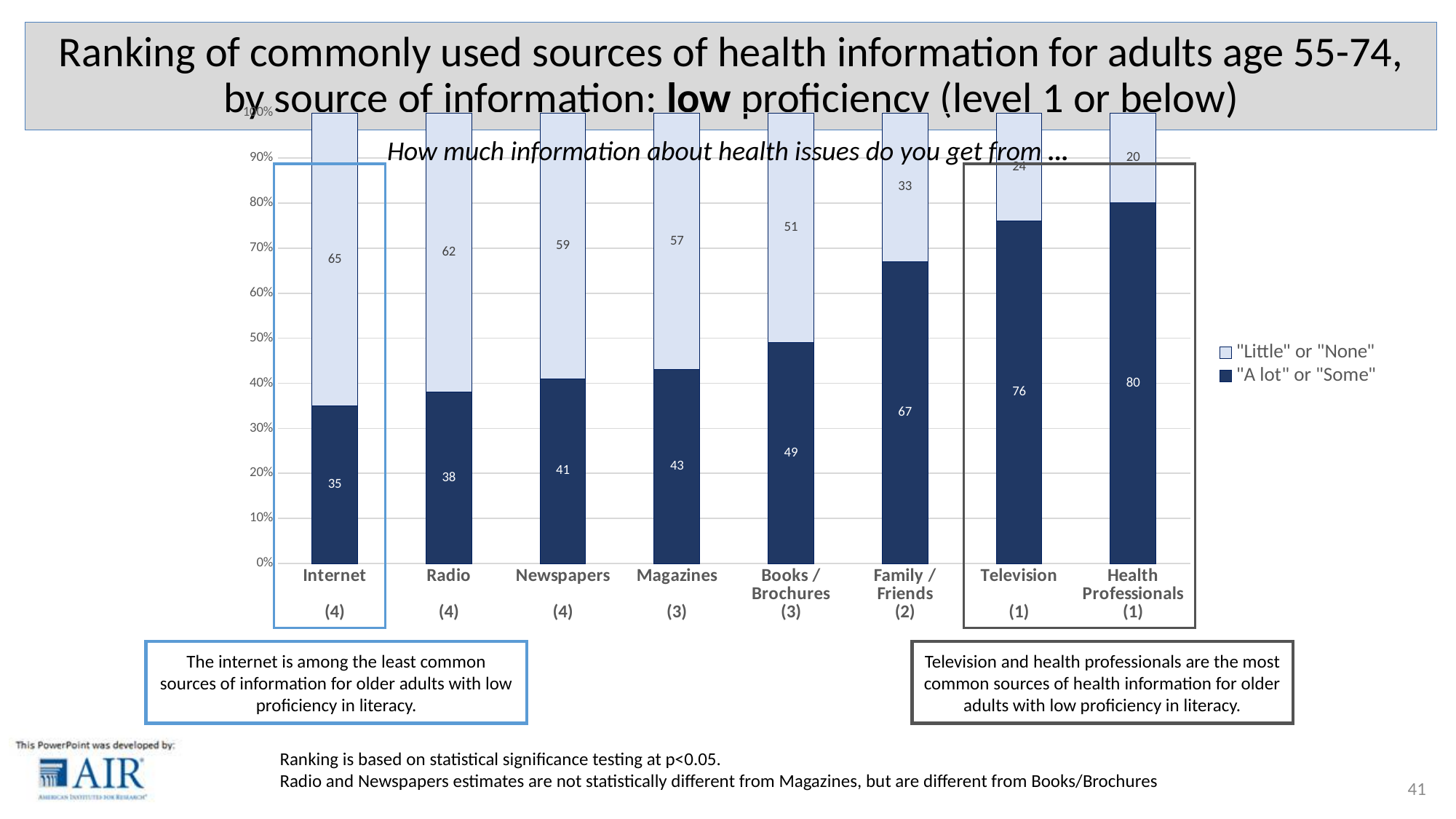
How many series does the legend list? 2 How many sources of health information are shown on the x axis? 8 What is the "Little" or "None" value for Health Professionals? 20 Do the "A lot" or "Some" values rise or fall moving from Internet to Health Professionals along the x axis? Rise Which is larger: the "Little" or "None" value for Magazines or for Books / Brochures? Magazines What is the "A lot" or "Some" value for Internet? 35 What is the difference between the "A lot" or "Some" values for Television and Radio? 38 Which source has the lowest "A lot" or "Some" value? Internet What kind of chart is shown on the slide? Stacked bar chart What is the total of the stacked bar for Newspapers? 100 What is the "A lot" or "Some" value for Family / Friends? 67 Which source has the highest "A lot" or "Some" value? Health Professionals